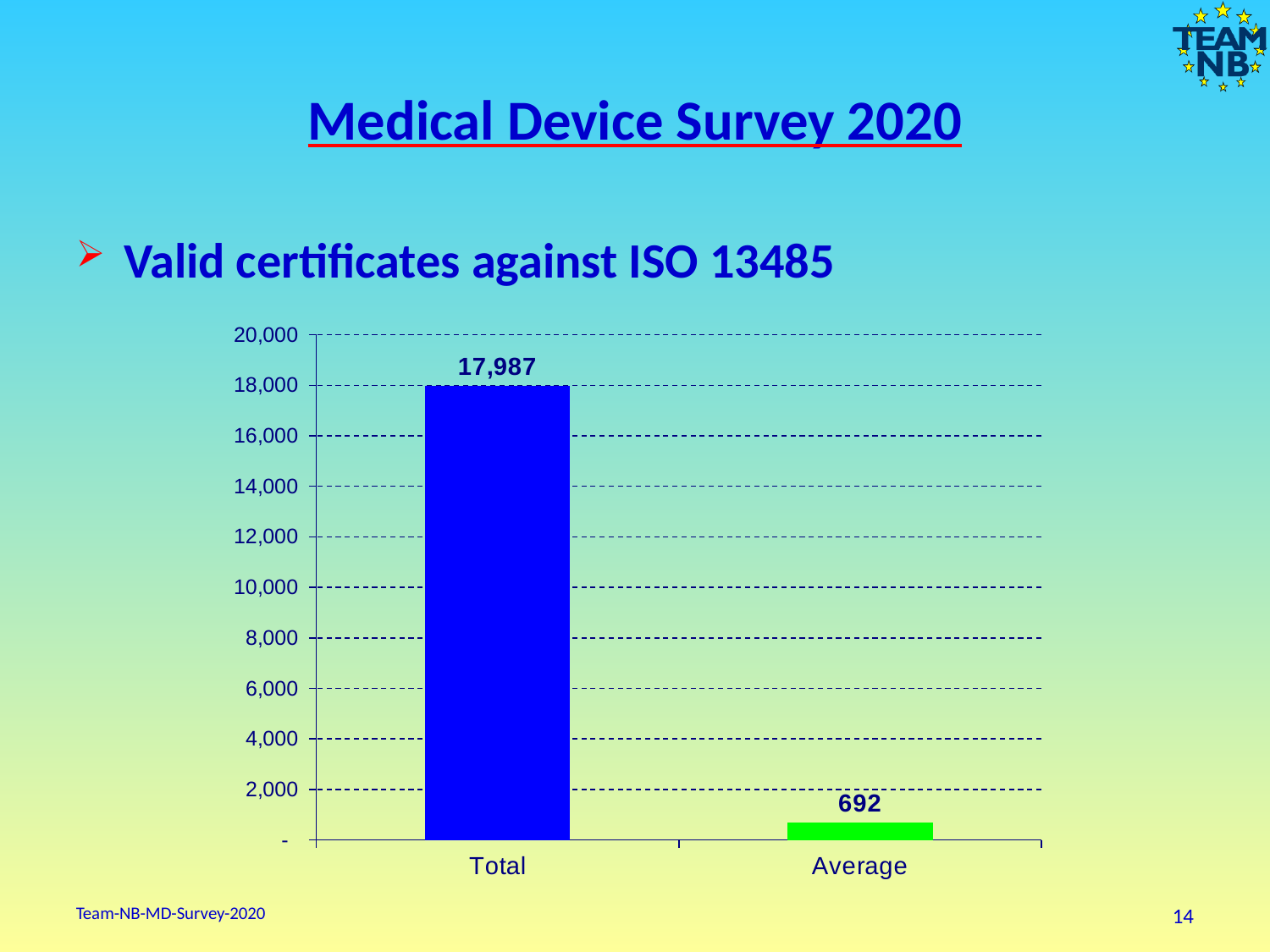
Which category has the highest value? Total Is the value for Average greater or less than 2,000? less What is the value for Average? 692 What is the maximum value shown on the y axis? 20,000 Is the value for Total greater or less than 16,000? greater What is the value for Total? 17,987 What colour is the bar for Average? green Which category has the lowest value? Average What kind of chart is shown on the slide? bar chart Which is larger, the value for Total or the value for Average? Total What is the difference between the Total and Average values? 17,295 How many categories are shown on the x axis? 2